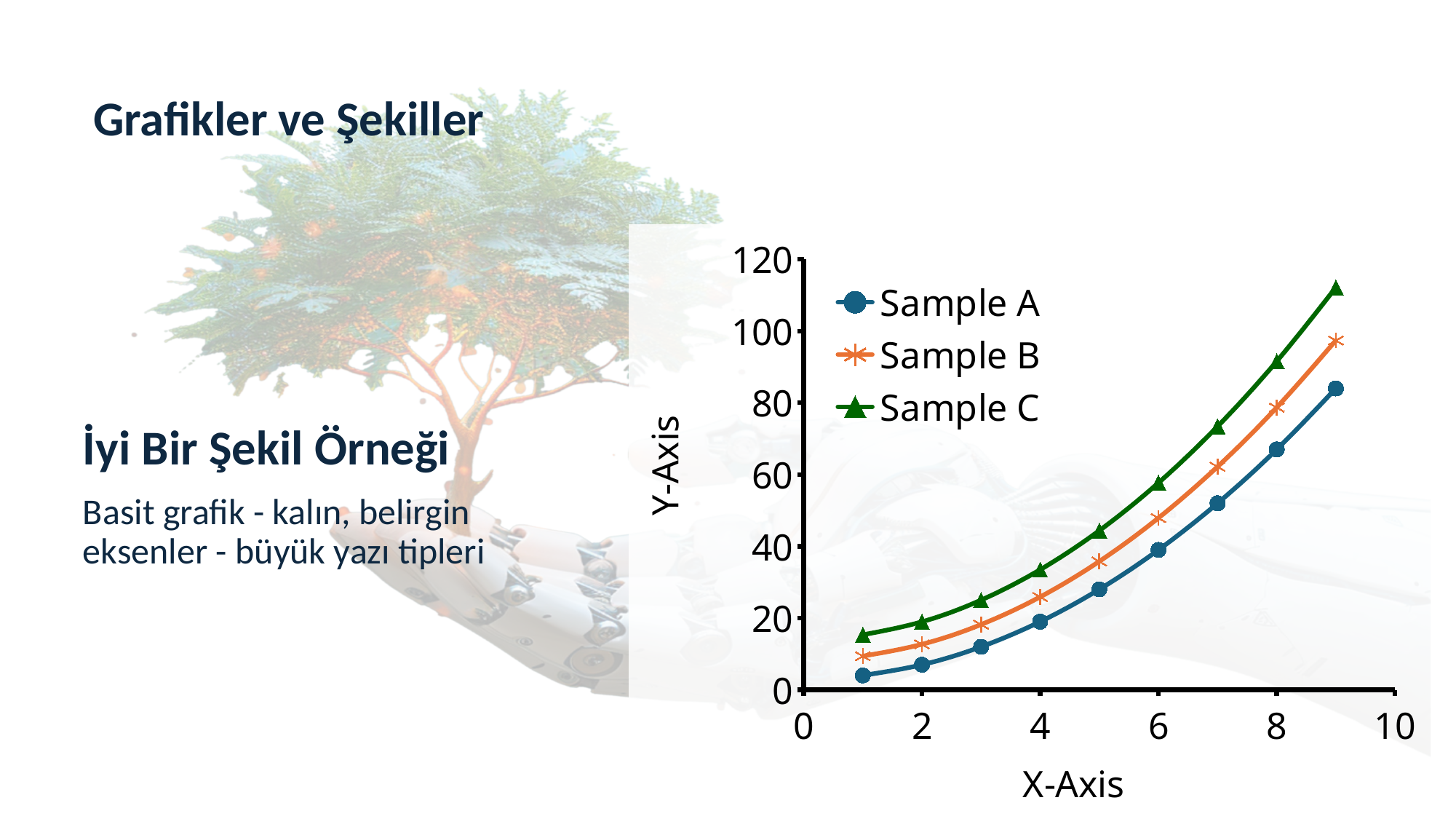
Which series has the lowest value at x = 9? Sample A Is the value for Sample C at x = 9 greater or less than 100? greater What is the title of the vertical axis? Y-Axis Which series is drawn with triangle markers? Sample C Which series has the highest value at x = 9? Sample C How many data points are plotted for Sample A? 9 Do the values for Sample C rise or fall as the x axis increases? rise What kind of chart is shown on the slide? line chart Is the value for Sample B at x = 5 greater or less than 40? less At x = 9, which is larger: the value for Sample C or the value for Sample A? Sample C Is the value for Sample A at x = 9 greater or less than 100? less How many series does the legend list? 3